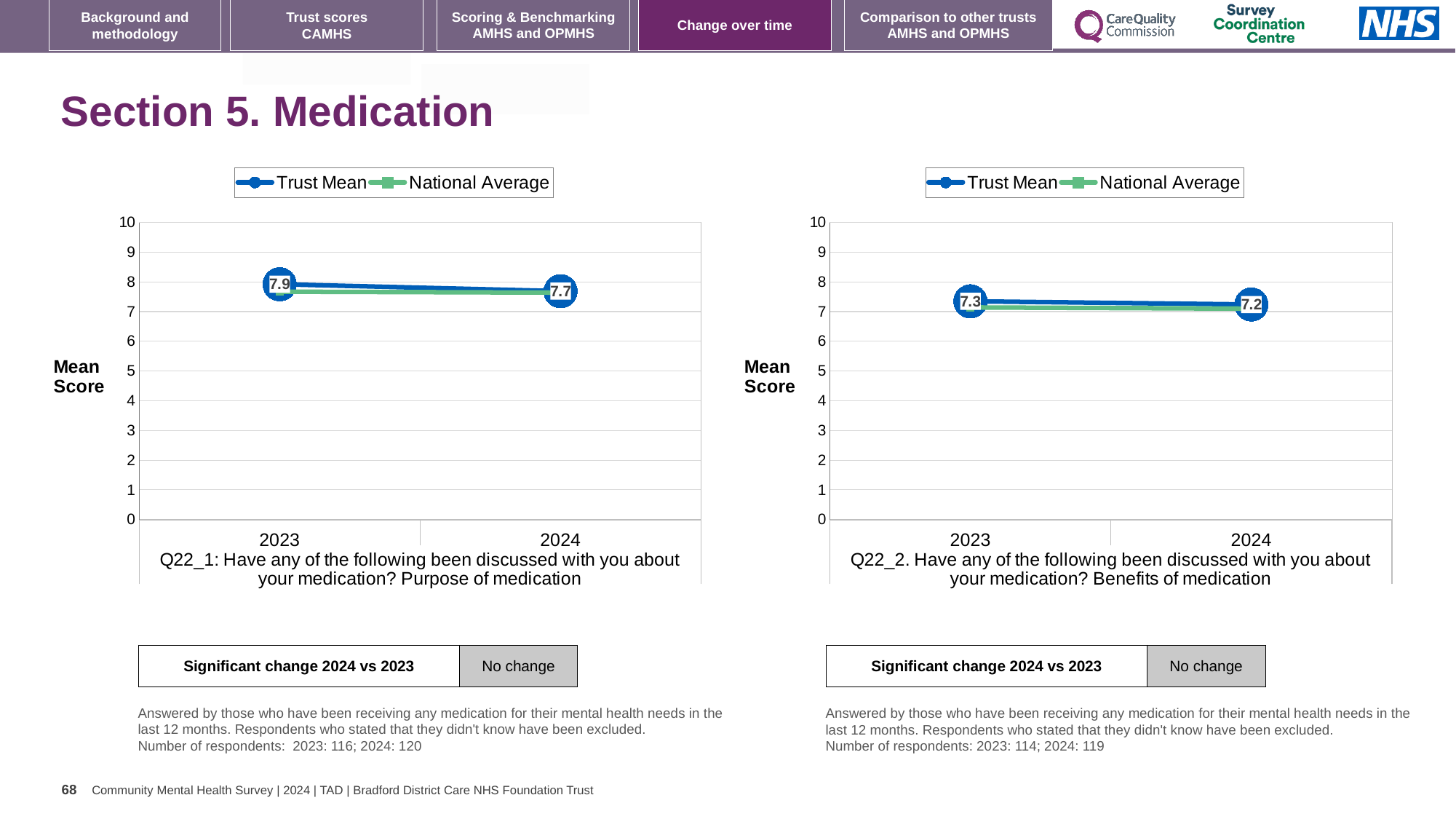
How many years are plotted on the x axis of the left chart (Q22_1: Purpose of medication)? 2 In the right chart (Q22_2: Benefits of medication), what is the Trust Mean for 2024? 7.2 In the left chart (Q22_1: Purpose of medication), by how much did the Trust Mean change from 2023 to 2024? 0.2 In the right chart (Q22_2: Benefits of medication), what is the Trust Mean for 2023? 7.3 In the left chart (Q22_1: Purpose of medication), does the Trust Mean rise or fall from 2023 to 2024? fall Which series is shown in green in the legend of the left chart (Q22_1: Purpose of medication)? National Average In the left chart (Q22_1: Purpose of medication), what is the Trust Mean for 2024? 7.7 In the left chart (Q22_1: Purpose of medication), what is the Trust Mean for 2023? 7.9 What kind of chart is used on this slide? line chart In the right chart (Q22_2: Benefits of medication), is the National Average for 2024 greater or less than 5? greater In the right chart (Q22_2: Benefits of medication), what is the difference between the Trust Mean in 2023 and 2024? 0.1 How many series does the legend of the right chart (Q22_2: Benefits of medication) list? 2